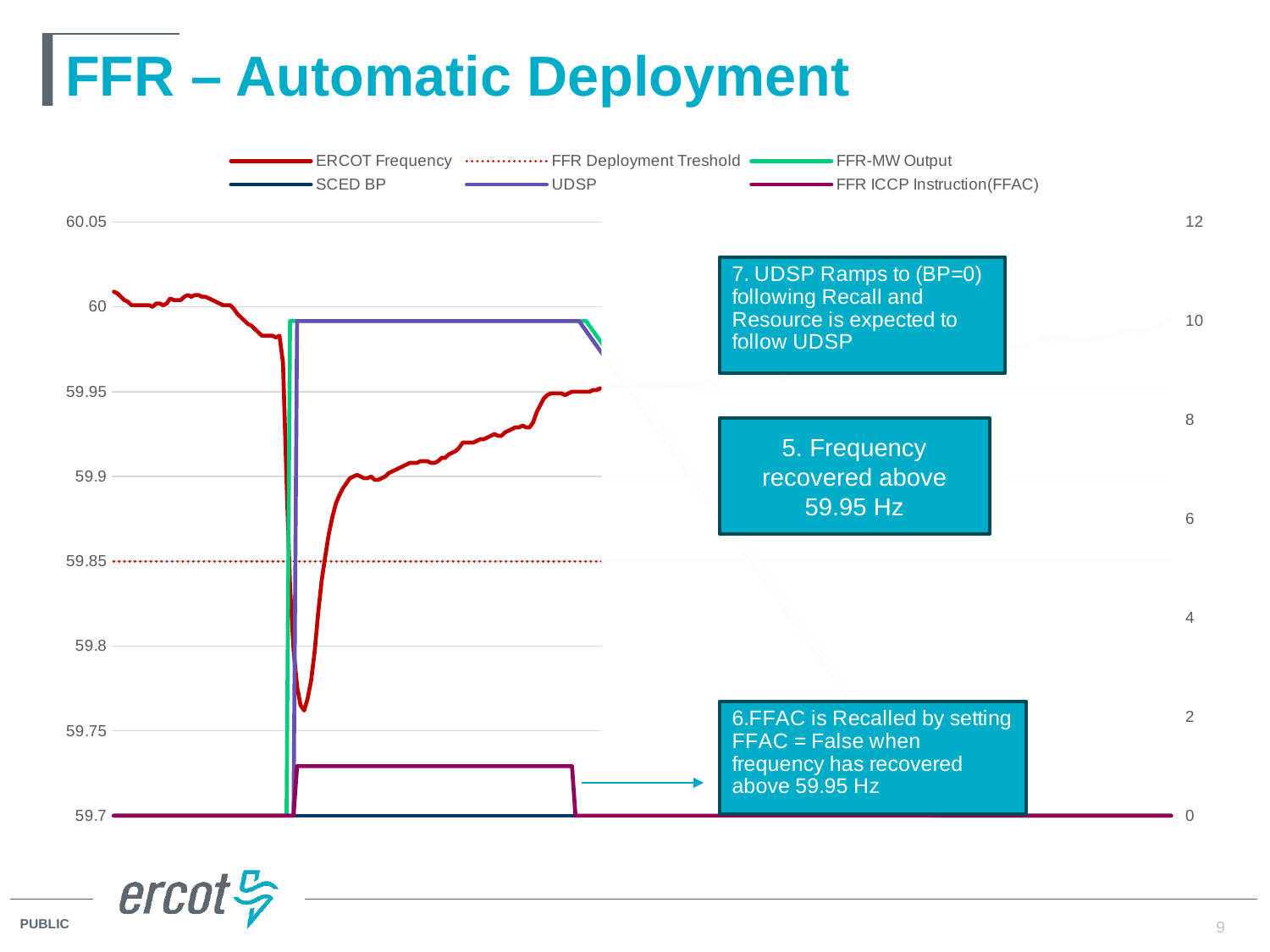
Is the plateau value of the FFR ICCP Instruction(FFAC) line (right axis) greater or less than 2? less What is the title of the slide containing the chart? FFR – Automatic Deployment What kind of chart is shown on the slide? line chart Is the lowest value reached by the ERCOT Frequency line greater or less than 59.8? less After its sharp dip, does the ERCOT Frequency line rise or fall as it moves to the right? rise Is the plateau value of the UDSP line (right axis) greater or less than 8? greater At what frequency value is the FFR Deployment Treshold line drawn? 59.85 What is the highest tick value shown on the right vertical axis? 12 Which legend series is drawn as a dotted line? FFR Deployment Treshold What is the highest tick value shown on the left vertical axis? 60.05 How many series does the chart legend list? 6